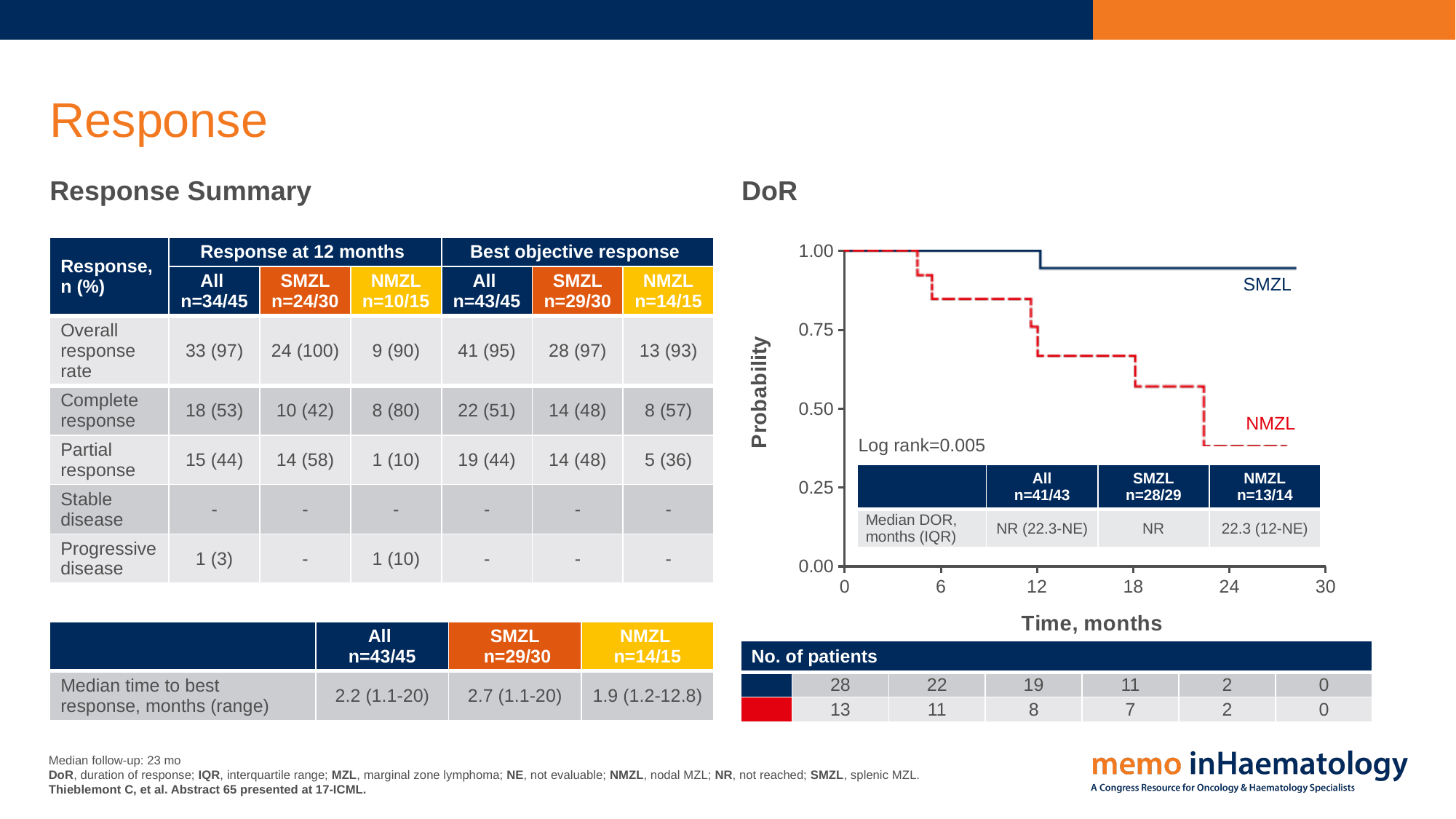
On the DoR chart, which curve is higher at 18 months, SMZL or NMZL? SMZL What log rank value is shown on the DoR chart? 0.005 According to the table inside the DoR chart, what is the median DOR in months (IQR) for NMZL? 22.3 (12-NE) On the DoR chart, is the NMZL probability at 6 months greater or less than 0.75? greater In the No. of patients table below the DoR chart, how many SMZL patients (blue row) are at risk at 12 months? 19 What is the y-axis title of the DoR chart? Probability How many series (curves) are plotted on the DoR chart? 2 On the DoR chart, does the NMZL curve rise or fall as time increases? fall What is the x-axis title of the DoR chart? Time, months What kind of chart is the DoR chart? line chart (Kaplan-Meier curve) On the DoR chart, is the NMZL probability at 24 months greater or less than 0.50? less On the DoR chart, is the SMZL probability at 24 months greater or less than 0.75? greater